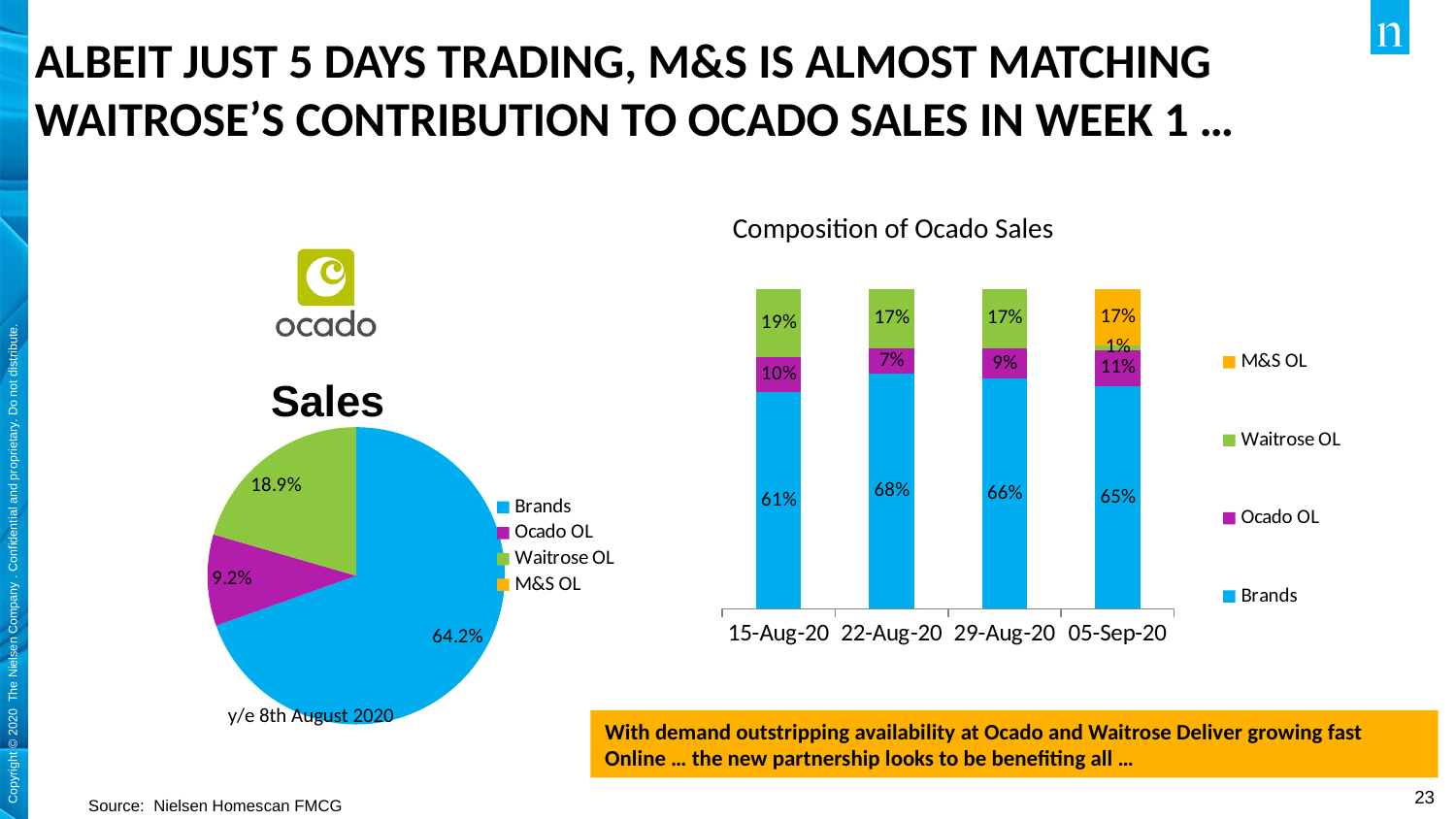
In the chart titled Composition of Ocado Sales, what is the Ocado OL value for 15-Aug-20? 10% In the pie chart titled Sales, how many entries does the legend list? 4 In the pie chart titled Sales, what share of sales is Ocado OL? 9.2% In the pie chart titled Sales, what share of sales is Brands? 64.2% In the pie chart titled Sales, which category has the largest slice? Brands In the pie chart titled Sales, what share of sales is Waitrose OL? 18.9% In the chart titled Composition of Ocado Sales, which week has the lowest Brands value? 15-Aug-20 In the chart titled Composition of Ocado Sales, what is the Brands value for 22-Aug-20? 68% In the chart titled Composition of Ocado Sales, what is the difference between the Brands values for 22-Aug-20 and 15-Aug-20? 7% What kind of chart is the Composition of Ocado Sales chart? Stacked bar chart In the chart titled Composition of Ocado Sales, what is the Waitrose OL value for 29-Aug-20? 17% In the chart titled Composition of Ocado Sales, how many weeks are shown on the x axis? 4